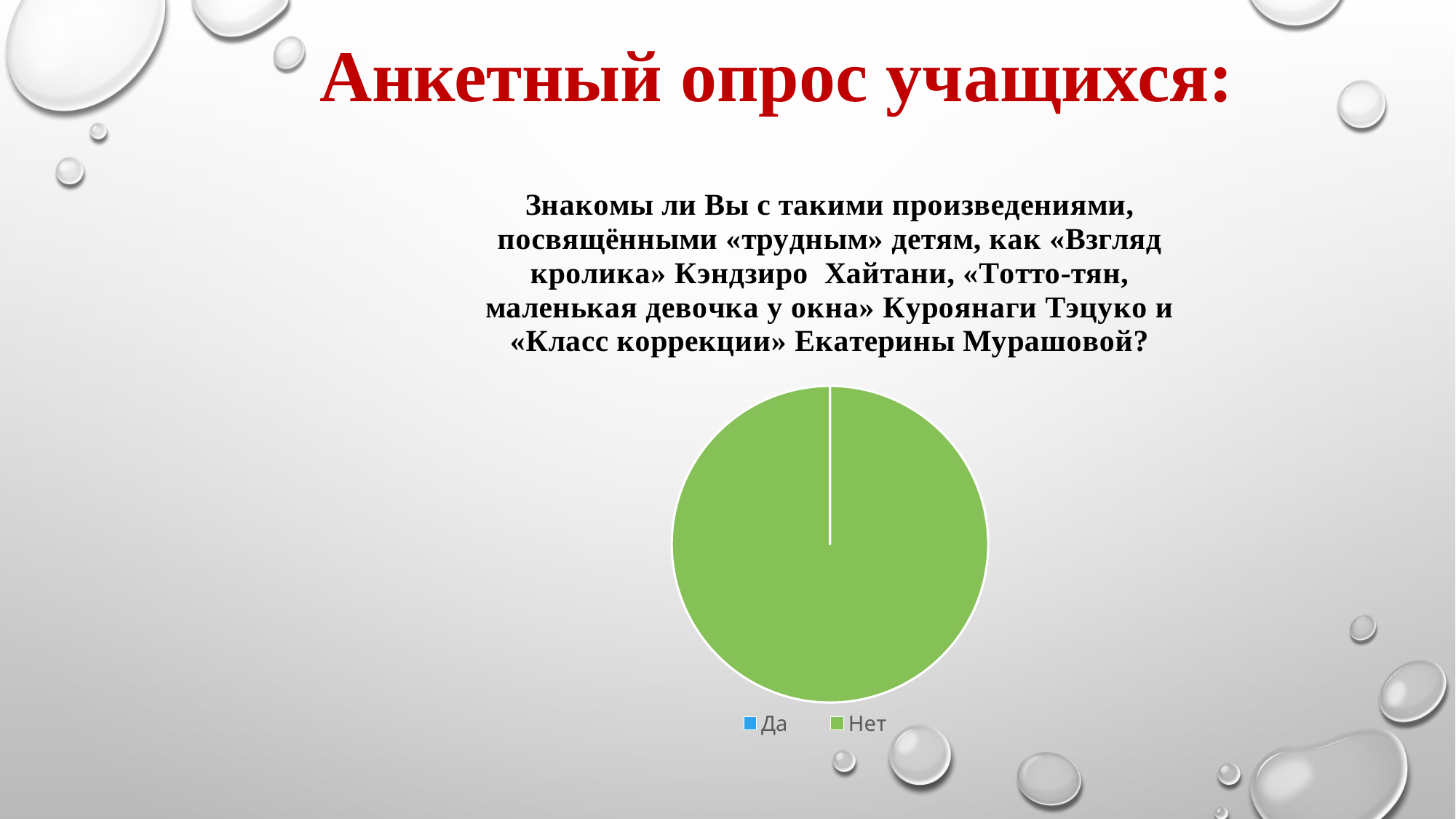
What colour represents the category Нет in the pie chart? green Which category takes up the largest share of the pie chart? Нет What kind of chart is shown on the slide? pie chart What colour is assigned to the category Да in the legend of the pie chart? blue How many categories does the legend of the pie chart list? 2 Which category takes up the smallest share of the pie chart? Да Which is larger in the pie chart, the share for Да or the share for Нет? Нет